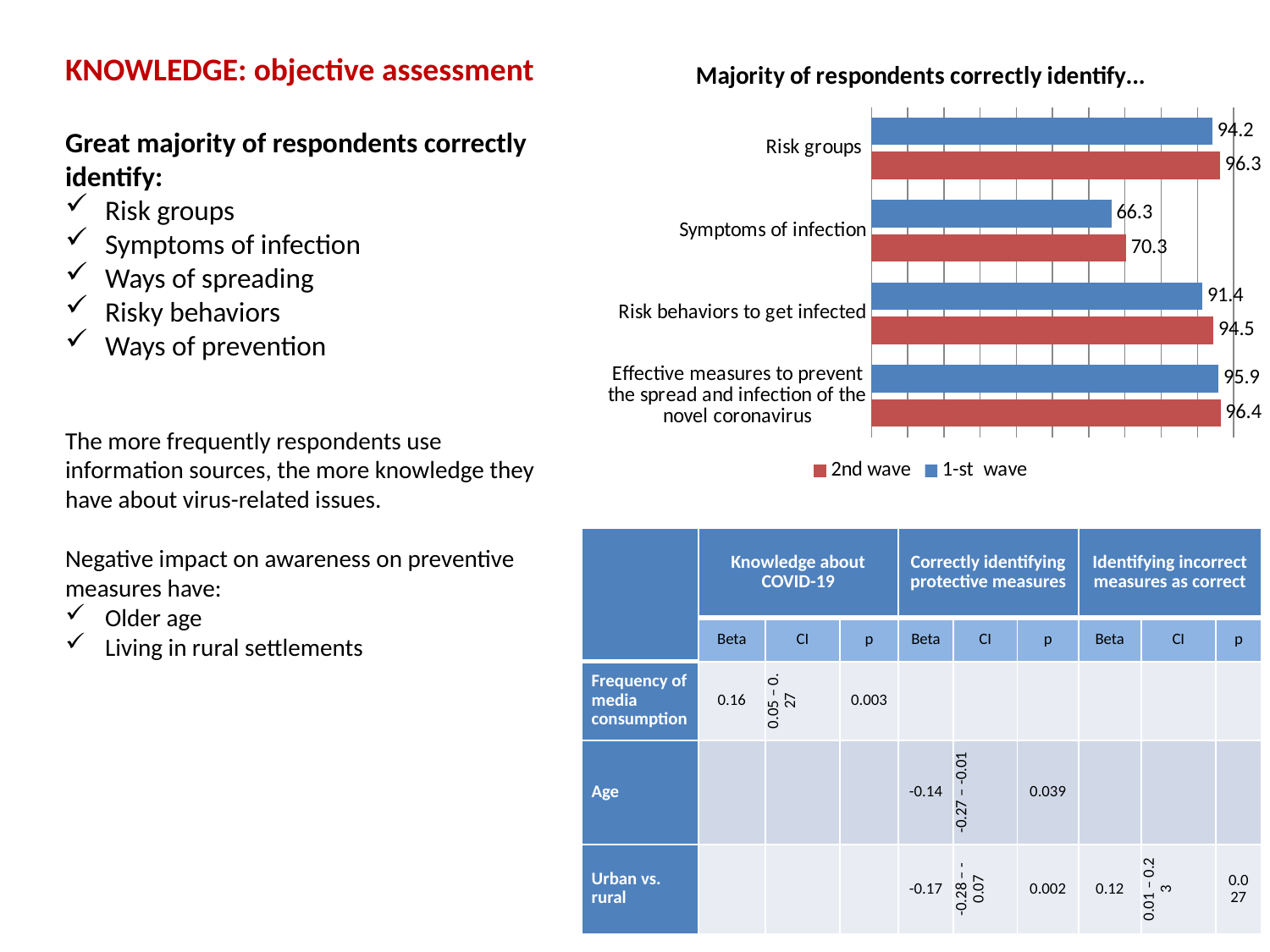
What is the 2nd wave value for Symptoms of infection? 70.3 What kind of chart is shown on the slide? bar chart What is the difference between the 2nd wave and 1-st wave values for Symptoms of infection? 4 What is the title of the chart? Majority of respondents correctly identify... Which category has the highest 2nd wave value? Effective measures to prevent the spread and infection of the novel coronavirus What is the 2nd wave value for Risk behaviors to get infected? 94.5 What is the 1-st wave value for Risk groups? 94.2 For Risk groups, which is larger: the 1-st wave value or the 2nd wave value? 2nd wave How many categories are shown on the chart? 4 What is the 1-st wave value for Effective measures to prevent the spread and infection of the novel coronavirus? 95.9 How many series does the chart legend list? 2 Which category has the lowest 1-st wave value? Symptoms of infection